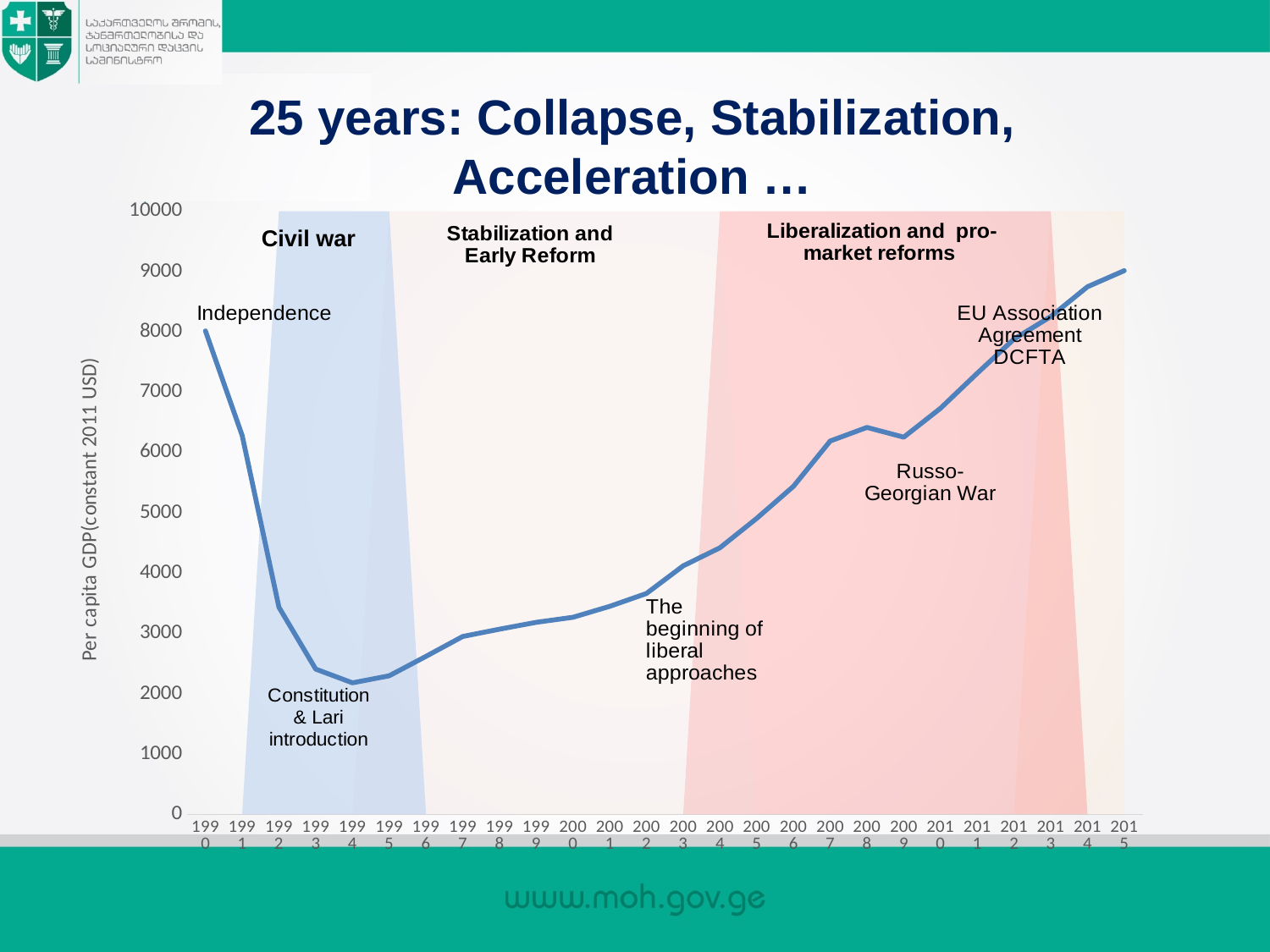
What is the label of the vertical axis of the chart? Per capita GDP(constant 2011 USD) How many years are plotted along the x axis of the chart? 26 Is the per capita GDP for 2012 greater or less than 7000? greater Which year has the higher per capita GDP, 1995 or 2005? 2005 Is the per capita GDP for 1990 greater or less than 7000? greater Does per capita GDP rise or fall between 1990 and 1994? fall What kind of chart is shown on the slide? line chart Is the per capita GDP for 1994 greater or less than 3000? less Which year has the highest per capita GDP on the chart? 2015 Which year has the lowest per capita GDP on the chart? 1994